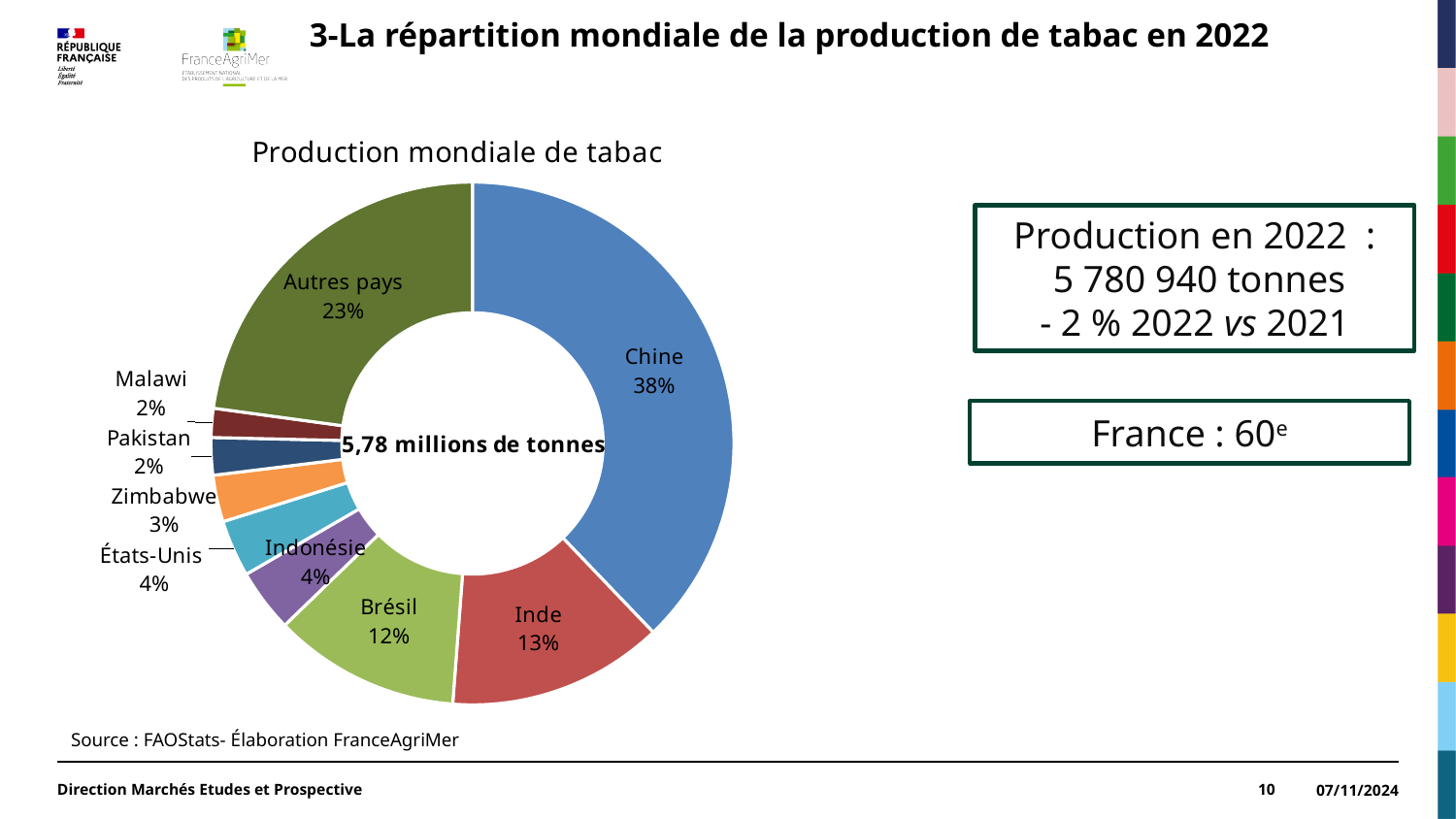
What text is written in the centre of the doughnut chart? 5,78 millions de tonnes What percentage does the chart show for Zimbabwe? 3% What share of world tobacco production does Chine account for in the chart? 38% Which slice is larger, Inde or Brésil? Inde What percentage is shown for Inde in the chart? 13% What is the difference in percentage points between Autres pays and Brésil? 11 Which named country has the largest slice in the chart? Chine Which slice is larger, États-Unis or Zimbabwe? États-Unis What share is shown for Brésil? 12% What is the difference in percentage points between Chine and Inde? 25 How many slices does the chart have? 9 What kind of chart is shown on the slide? Pie chart (doughnut)